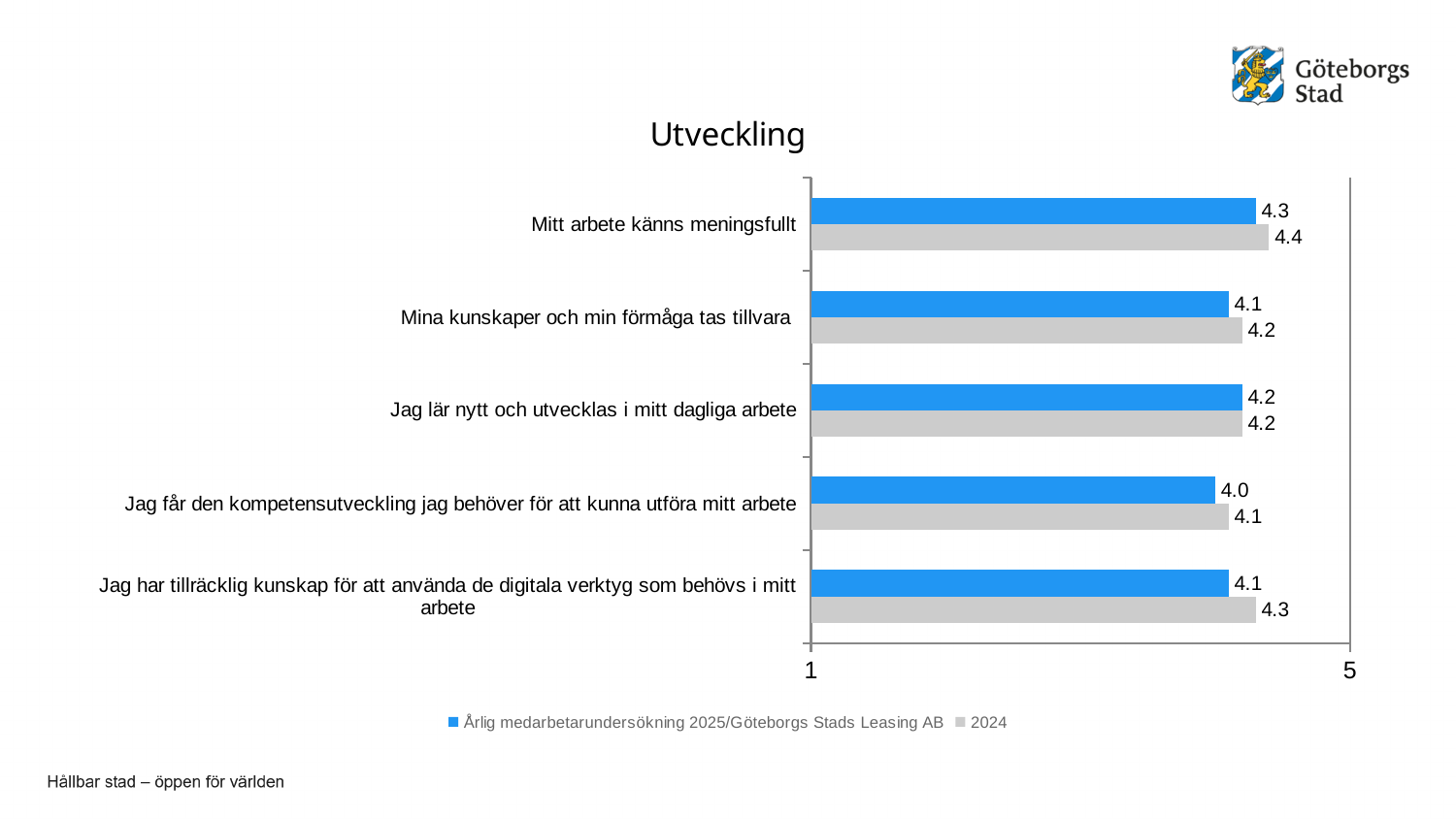
What is the 2024 value for 'Jag har tillräcklig kunskap för att använda de digitala verktyg som behövs i mitt arbete'? 4.3 What kind of chart is shown on the slide? Bar chart What is the difference between the 2024 and 2025 values for 'Jag har tillräcklig kunskap för att använda de digitala verktyg som behövs i mitt arbete'? 0.2 What is the 2025 value for 'Mitt arbete känns meningsfullt'? 4.3 What is the 2025 value for 'Jag får den kompetensutveckling jag behöver för att kunna utföra mitt arbete'? 4.0 For 'Mitt arbete känns meningsfullt', which is larger: the 2025 value or the 2024 value? 2024 Which category has the highest 2024 value? Mitt arbete känns meningsfullt How many categories are shown in the chart? 5 What is the title of the chart? Utveckling How many series does the legend list? 2 What is the 2024 value for 'Mina kunskaper och min förmåga tas tillvara'? 4.2 Which category has the lowest 2025 value? Jag får den kompetensutveckling jag behöver för att kunna utföra mitt arbete